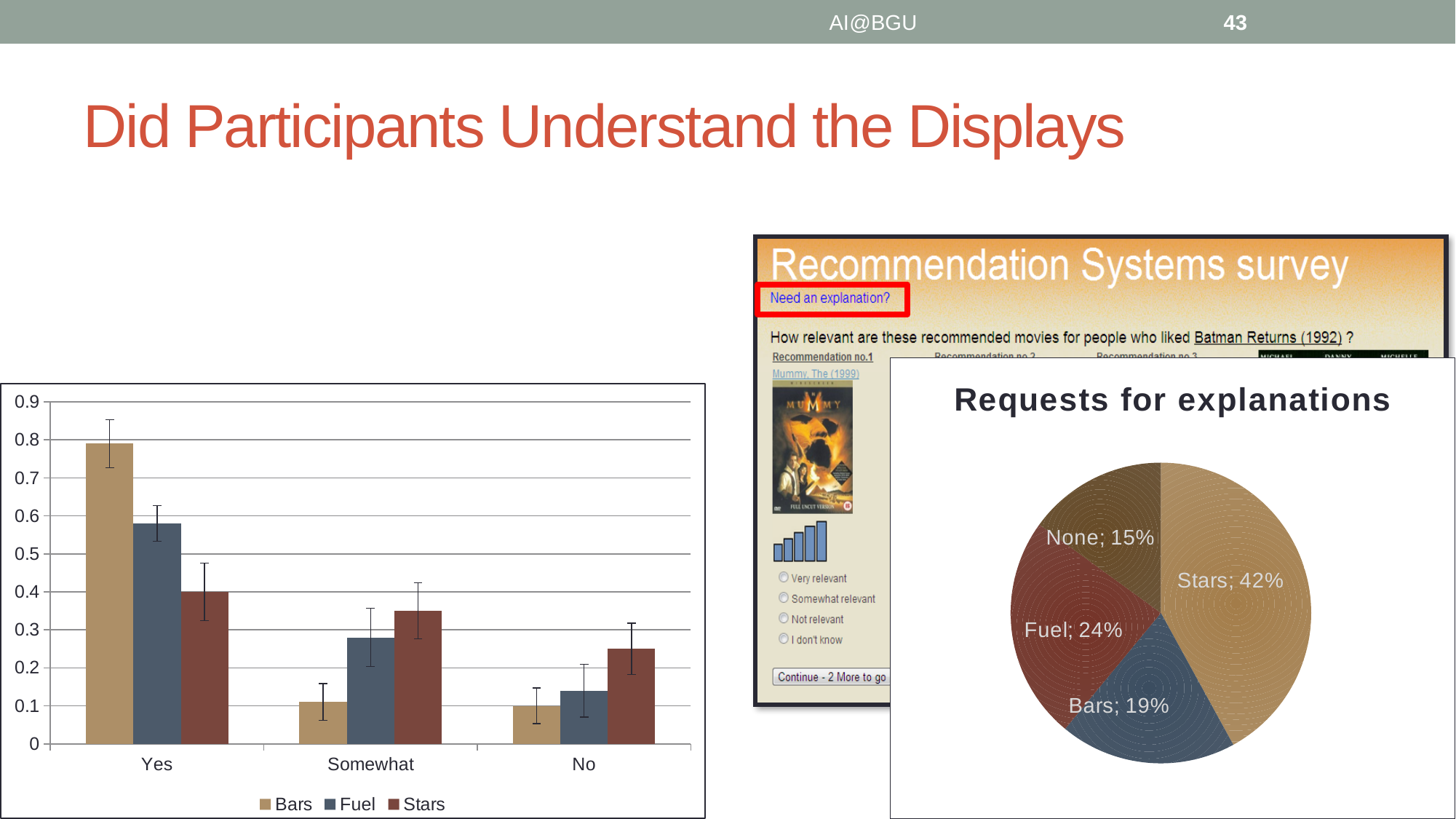
In the bar chart on the left of the slide, which series has the tallest bar for the "Yes" category? Bars In the pie chart titled "Requests for explanations", how many slices are there? 4 In the pie chart titled "Requests for explanations", which slice is the largest? Stars In the bar chart on the left of the slide, is the value of Stars for "No" greater or less than 0.3? less In the pie chart titled "Requests for explanations", what share is labelled for Fuel? 24% In the pie chart titled "Requests for explanations", which slice is the smallest? None In the bar chart on the left of the slide, for the "Somewhat" category, which is larger: Bars or Stars? Stars In the bar chart on the left of the slide, do the values for the Bars series rise or fall from "Yes" to "No"? fall In the bar chart on the left of the slide, how many series does the legend list? 3 In the pie chart titled "Requests for explanations", what share is labelled for Stars? 42% In the bar chart on the left of the slide, is the value of Bars for "Yes" greater or less than 0.7? greater In the pie chart titled "Requests for explanations", what is the difference in percentage points between the Stars slice and the Bars slice? 23